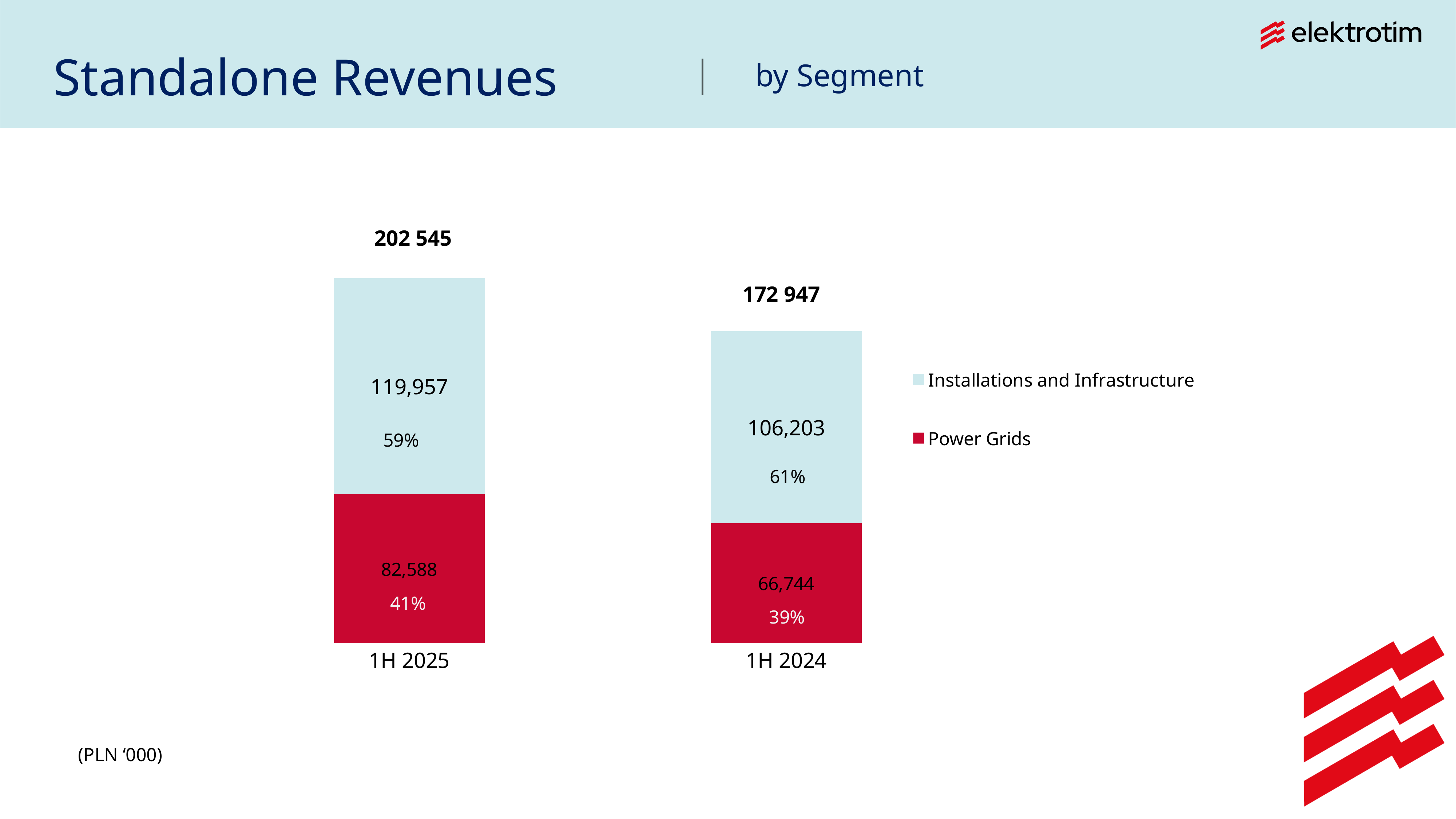
What is the total standalone revenue shown for 1H 2025? 202 545 What type of chart is shown on the slide? Stacked bar chart Which segment is larger in 1H 2024, Installations and Infrastructure or Power Grids? Installations and Infrastructure What is the difference between Installations and Infrastructure revenue in 1H 2025 and 1H 2024? 13,754 What is the Installations and Infrastructure revenue for 1H 2025? 119,957 What is the total standalone revenue shown for 1H 2024? 172 947 What share of 1H 2025 revenue does Power Grids represent? 41% How many periods are shown on the chart? 2 What is the difference between Power Grids revenue in 1H 2025 and 1H 2024? 15,844 How many series does the legend list? 2 What is the Power Grids revenue for 1H 2024? 66,744 Which period has the higher total standalone revenue? 1H 2025